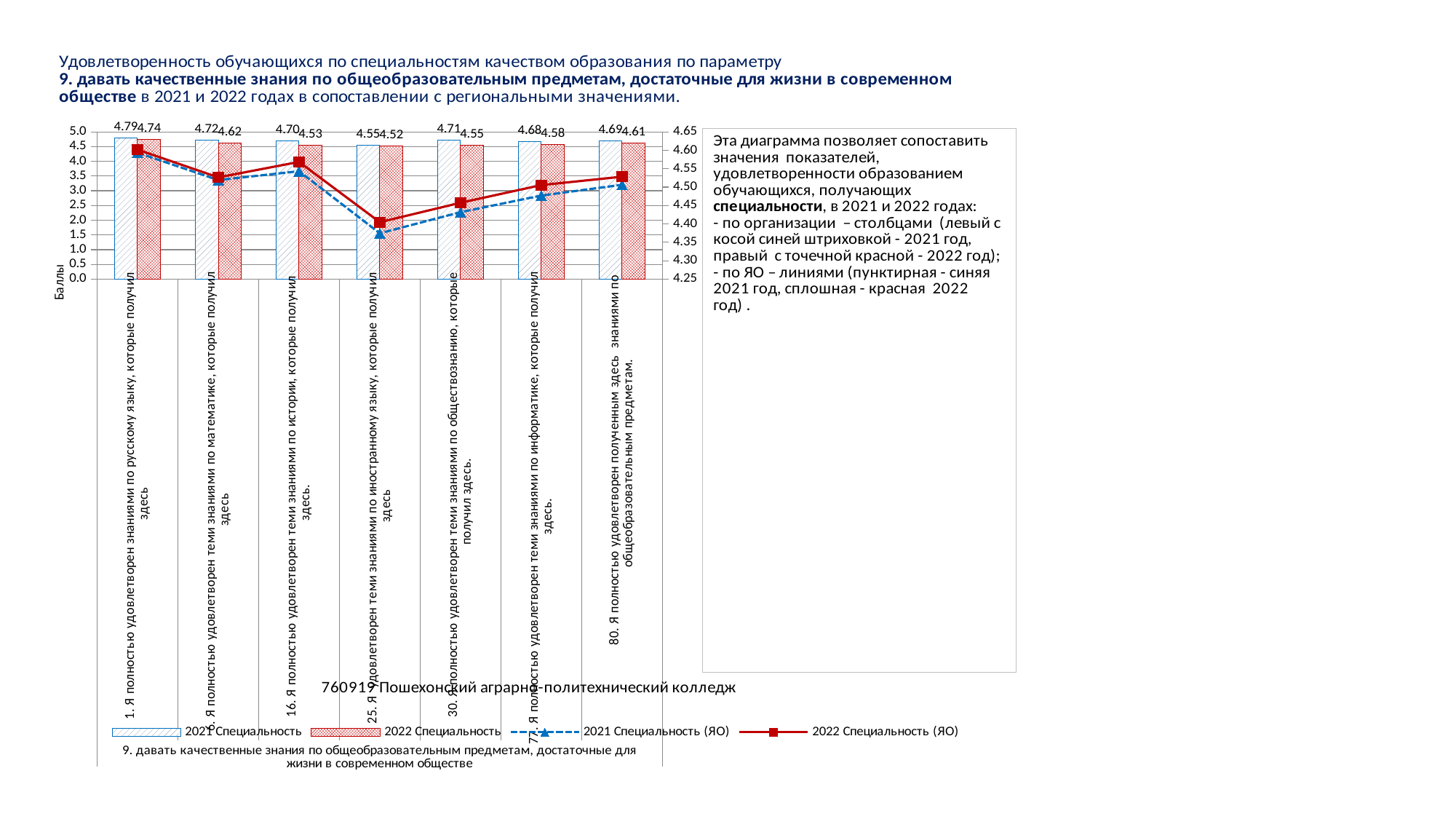
What is the value of the 2022 Специальность bar for the category about информатика (category 77)? 4.58 Which category has the lowest 2022 Специальность bar? 25. Я удовлетворен теми знаниями по иностранному языку, которые получил здесь Is the 2022 Специальность (ЯО) line value for the category about иностранный язык (category 25) greater or less than 4.45 on the right axis? less Which category has the highest 2021 Специальность bar? 1. Я полностью удовлетворен знаниями по русскому языку, которые получил здесь What is the value of the 2021 Специальность bar for the category about русский язык (category 1)? 4.79 According to the legend, which series is drawn as a dashed blue line? 2021 Специальность (ЯО) What is the difference between the 2021 and 2022 Специальность bars for the category about история (category 16)? 0.17 What kind of chart is shown on the slide? Combined bar and line chart How many categories are shown on the x axis of the chart? 7 What is the value of the 2022 Специальность bar for the category about иностранный язык (category 25)? 4.52 How many series does the chart legend list? 4 Which is larger for the category about математика (category 2): the 2021 Специальность bar or the 2022 Специальность bar? 2021 Специальность